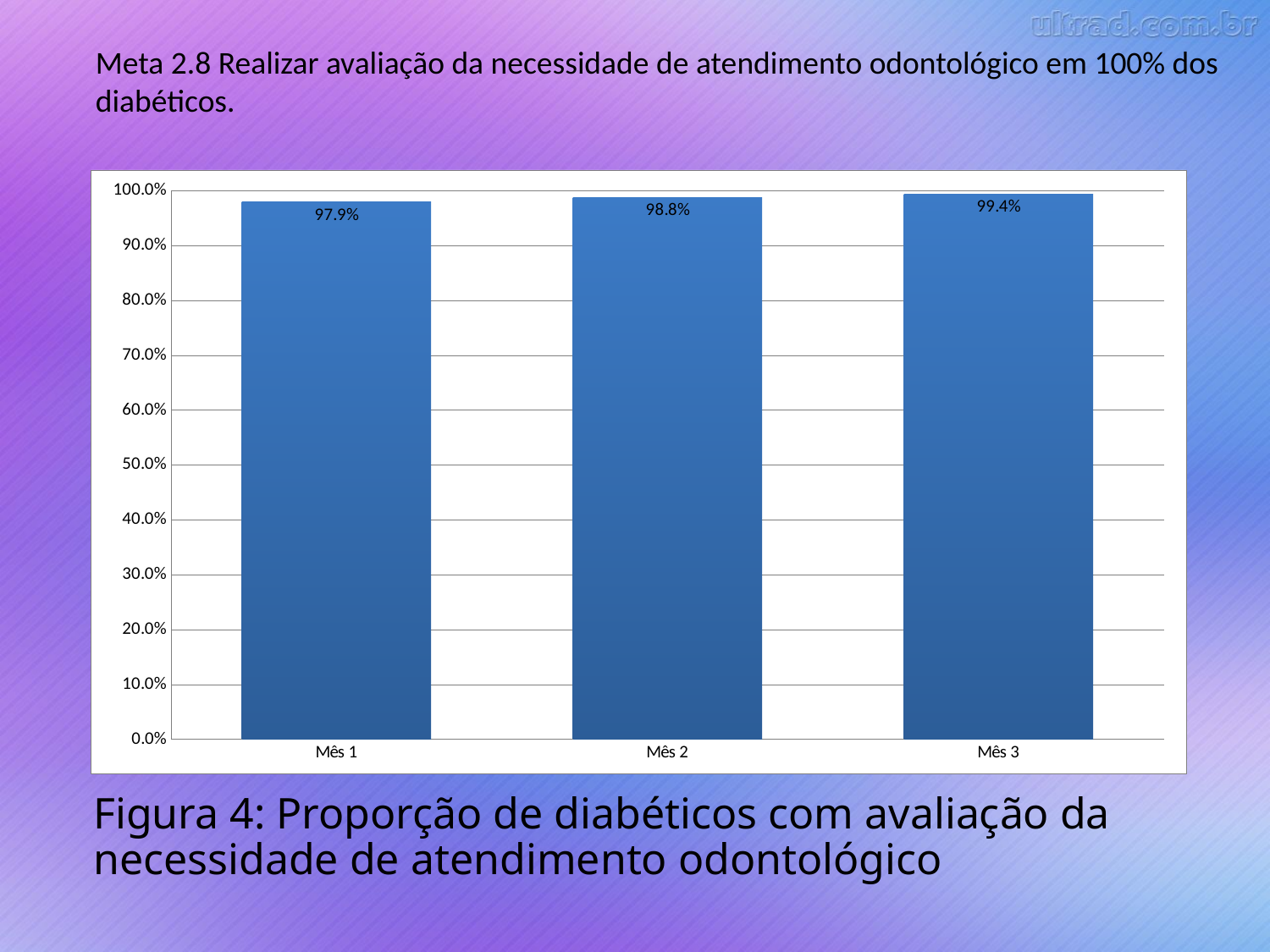
Which month has the highest value? Mês 3 Which is larger, the value for Mês 2 or the value for Mês 3? Mês 3 What is the value for Mês 3? 99.4% Do the values rise or fall from Mês 1 to Mês 3? Rise What is the value for Mês 1? 97.9% What is the difference between the values for Mês 2 and Mês 1? 0.9% What is the difference between the values for Mês 3 and Mês 1? 1.5% How many months are shown on the x axis? 3 What kind of chart is shown on the slide? Bar chart Is the value for Mês 1 greater or less than 90.0%? greater What is the value for Mês 2? 98.8% Which month has the lowest value? Mês 1